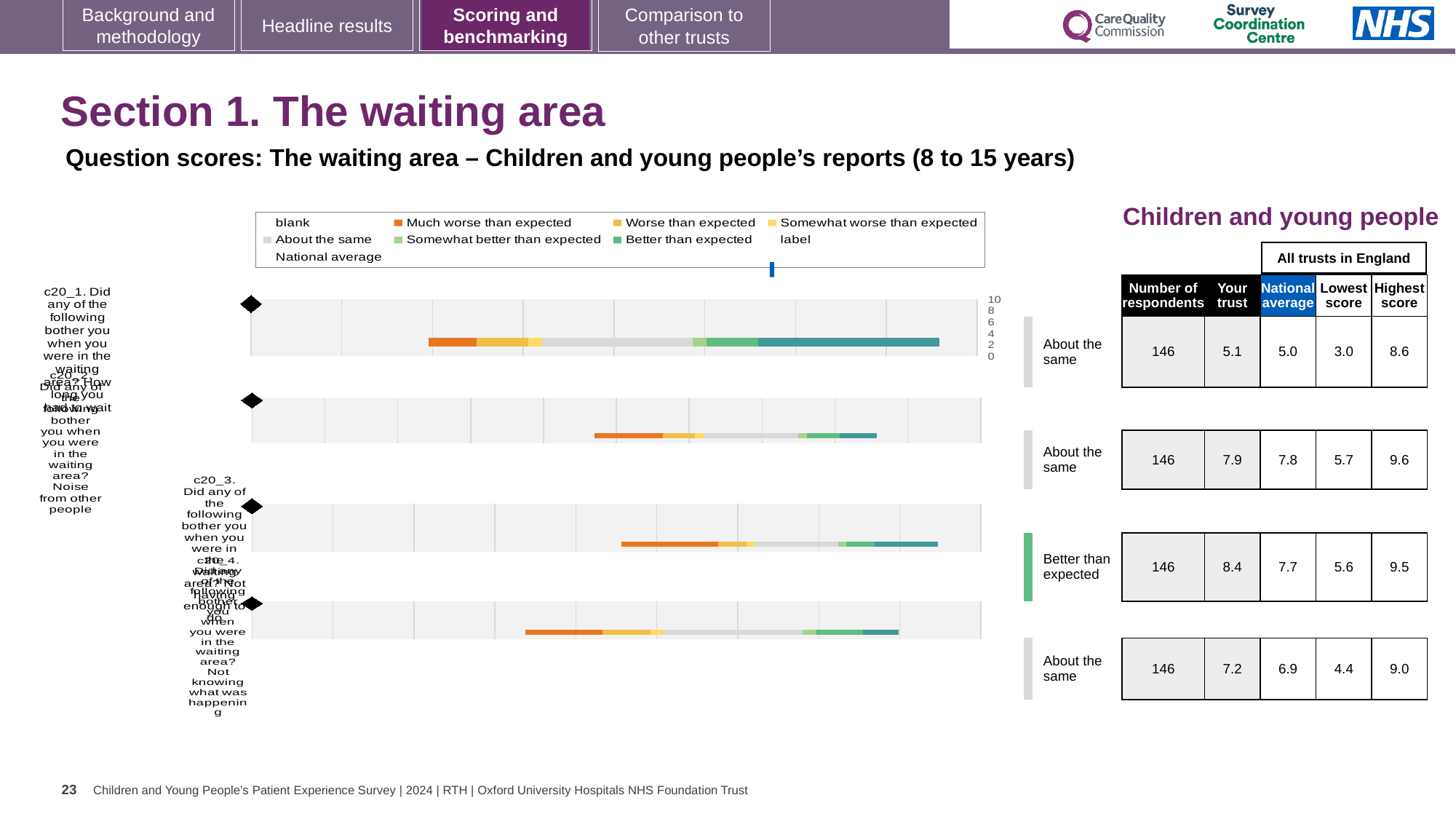
What is the highest score across all trusts in England for the first row (c20_1)? 8.6 What is the 'Your trust' score for the second row (c20_2, how long you had to wait)? 7.9 Which question row has the highest 'Your trust' score? c20_3 (Not having enough to do) How many entries does the chart legend list? 9 What is the national average score for the third row (c20_3, not having enough to do)? 7.7 How many question rows (bars) are plotted in the chart? 4 Which question row has the lowest 'Your trust' score? c20_1 (Noise from other people) For the third row (c20_3), how much higher is the 'Your trust' score than the national average? 0.7 How many respondents are reported for the first row (c20_1)? 146 Which question row is rated 'Better than expected' rather than 'About the same'? c20_3 (Not having enough to do) What kind of chart is shown on the slide? Bar chart Which has the larger 'Your trust' score: the second row (c20_2) or the fourth row (c20_4)? c20_2